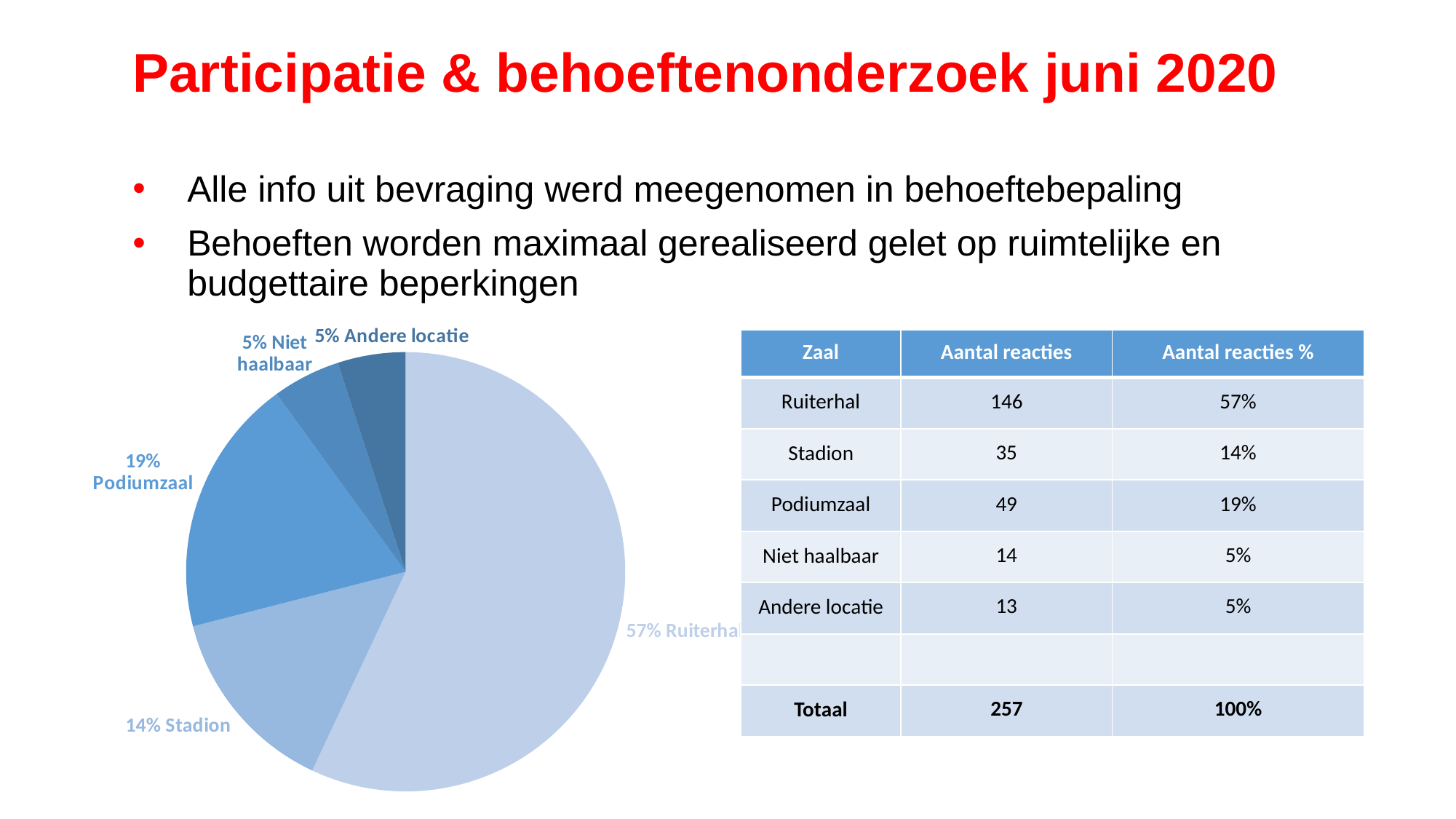
What share of the pie does Podiumzaal have? 19% Which slice of the pie chart is drawn in the darkest blue? Andere locatie Which slice of the pie chart is the largest? Ruiterhal Which slice is larger in the pie chart, Podiumzaal or Stadion? Podiumzaal What kind of chart is shown on the slide? pie chart What is the difference in percentage points between the Podiumzaal slice and the Stadion slice? 5 What is the difference in percentage points between the Ruiterhal slice and the Podiumzaal slice? 38 How many slices does the pie chart have? 5 What share of the pie does Ruiterhal have? 57% What share of the pie does Stadion have? 14% Which two slices of the pie chart share the same percentage? Niet haalbaar and Andere locatie